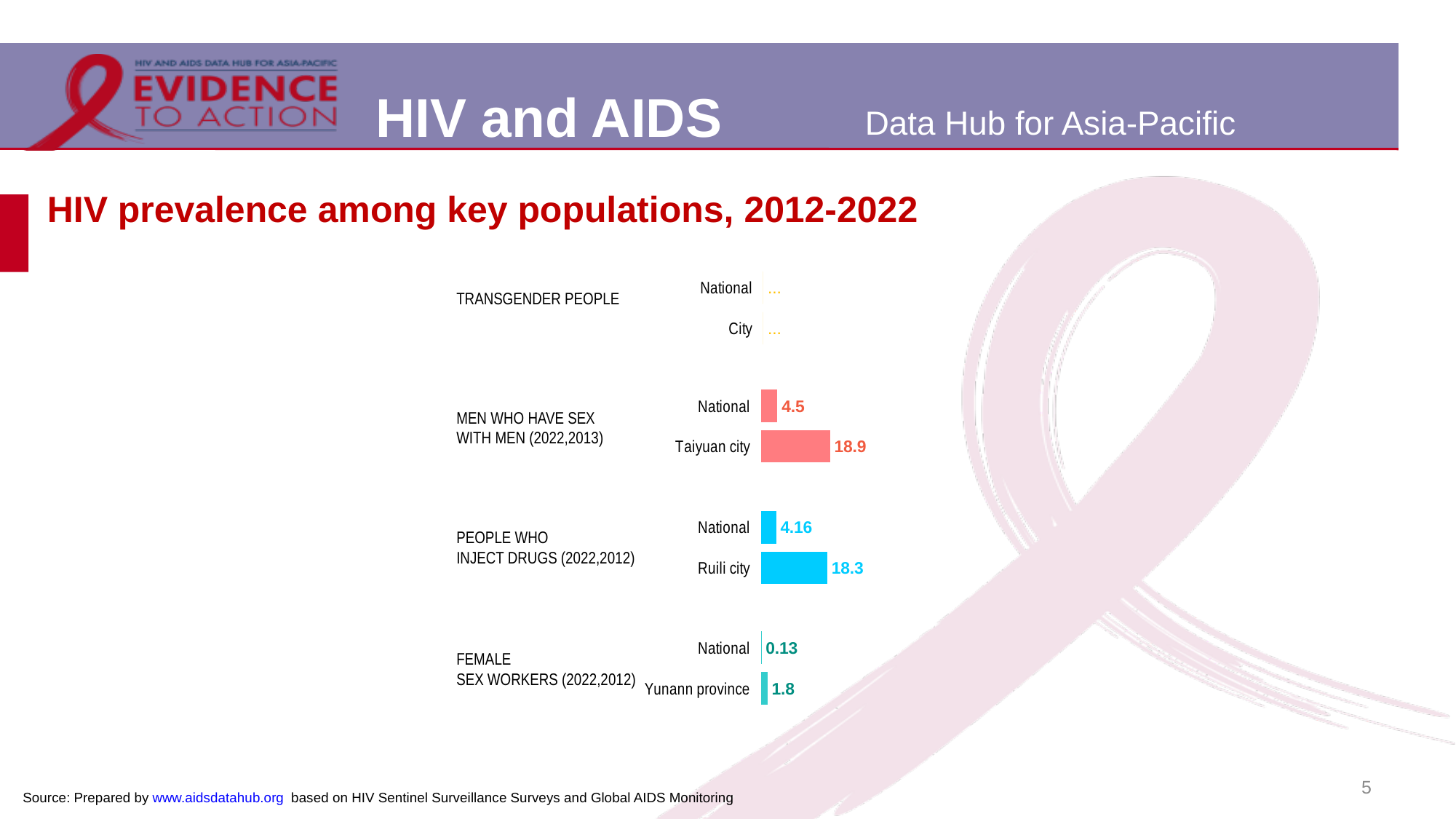
What is the HIV prevalence value shown for Yunann province among female sex workers? 1.8 Which bar has the lowest printed value on the chart? National (female sex workers) Which bar has the highest value on the chart? Taiyuan city (men who have sex with men) What kind of chart is shown on the slide? Bar chart What is the national HIV prevalence value shown for men who have sex with men? 4.5 What is the HIV prevalence value shown for Ruili city among people who inject drugs? 18.3 Which is larger: the Ruili city value for people who inject drugs or the Yunann province value for female sex workers? Ruili city What is the HIV prevalence value shown for Taiyuan city among men who have sex with men? 18.9 What is the national HIV prevalence value shown for people who inject drugs? 4.16 What is the national HIV prevalence value shown for female sex workers? 0.13 What value is shown for transgender people at the national level? ... (no data) What is the difference between the Taiyuan city value and the national value for men who have sex with men? 14.4